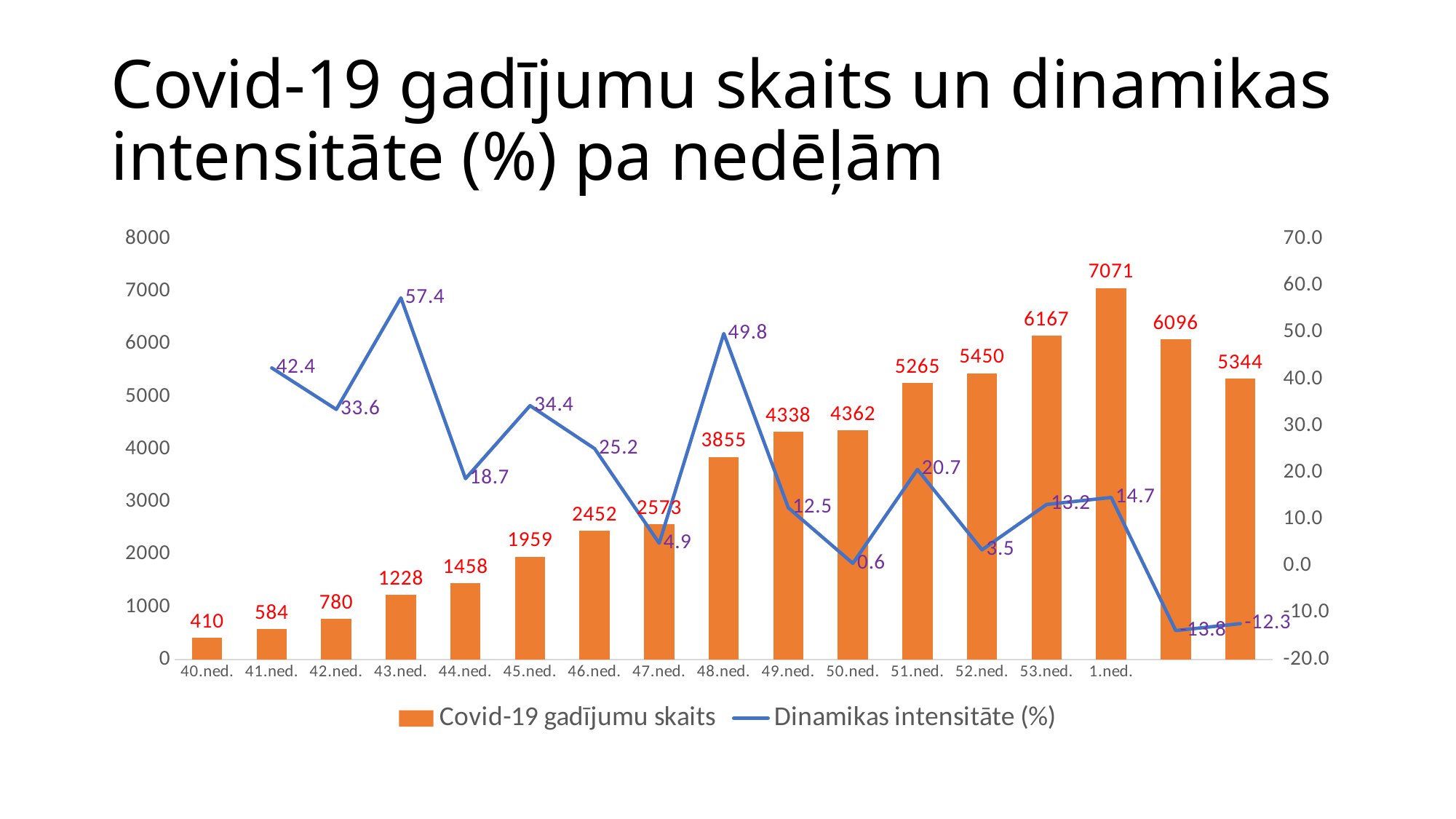
Which labelled week has the highest Covid-19 gadījumu skaits? 1.ned. What is the Dinamikas intensitāte (%) value for 43.ned.? 57.4 How many series does the legend list? 2 Do the Covid-19 gadījumu skaits bars generally rise or fall from 40.ned. to 1.ned.? Rise What is the Covid-19 gadījumu skaits value for 48.ned.? 3855 What kind of chart is shown on the slide? Combined bar and line chart What colour are the Covid-19 gadījumu skaits bars? Orange Which is larger, the Covid-19 gadījumu skaits for 45.ned. or for 46.ned.? 46.ned. What is the difference in Covid-19 gadījumu skaits between 1.ned. and 53.ned.? 904 Which week has the highest Dinamikas intensitāte (%) value? 43.ned. Which week has the lowest Covid-19 gadījumu skaits? 40.ned. What is the Dinamikas intensitāte (%) value for 50.ned.? 0.6